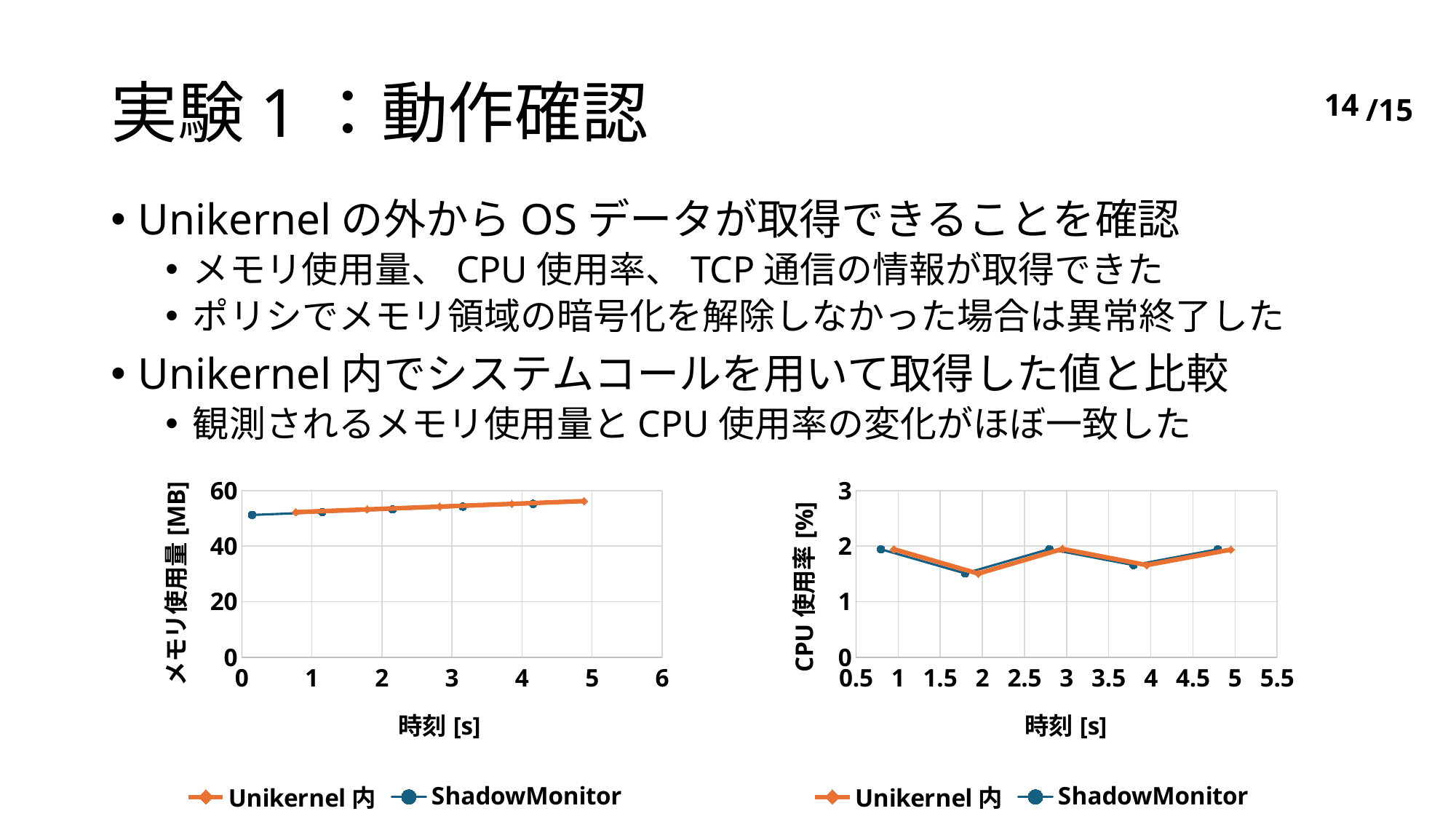
In the right chart (CPU 使用率 [%]), is the Unikernel 内 value at 2 s greater or less than 2? less In the left chart (メモリ使用量 [MB]), is the Unikernel 内 value at 5 s greater or less than 60? less In the right chart (CPU 使用率 [%]), is the Unikernel 内 value at 3 s greater or less than 1? greater In the left chart (メモリ使用量 [MB]), what are the two series named in the legend? Unikernel 内 and ShadowMonitor What kind of chart is the right chart (CPU 使用率 [%])? line chart In the right chart (CPU 使用率 [%]), what is the label of the x axis? 時刻 [s] In the right chart (CPU 使用率 [%]), does the Unikernel 内 value rise or fall between 1 s and 2 s? fall How many series does the legend of the right chart (CPU 使用率 [%]) list? 2 What kind of chart is the left chart (メモリ使用量 [MB])? line chart How many series does the legend of the left chart (メモリ使用量 [MB]) list? 2 In the left chart (メモリ使用量 [MB]), do the Unikernel 内 values rise or fall as time increases from 1 s to 5 s? rise